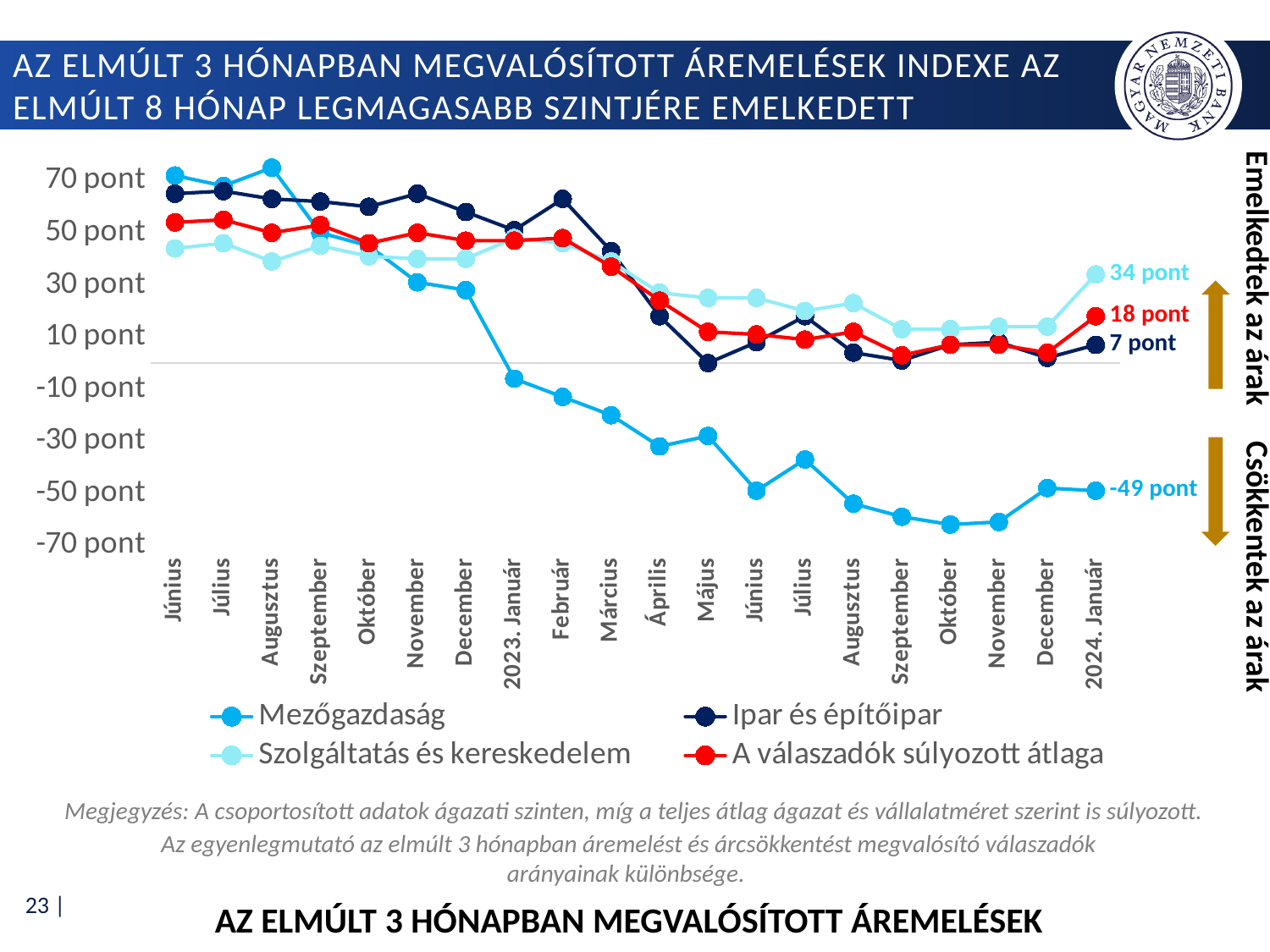
Does the Mezőgazdaság series rise or fall overall from Június 2022 to 2024. Január? fall What is the value for Szolgáltatás és kereskedelem in 2024. Január? 34 pont Which series has the lowest value in 2024. Január? Mezőgazdaság What is the difference between the Szolgáltatás és kereskedelem and A válaszadók súlyozott átlaga values in 2024. Január? 16 pont What is the value for Ipar és építőipar in 2024. Január? 7 pont What is the value for Mezőgazdaság in 2024. Január? -49 pont How many series does the legend list? 4 What kind of chart is shown on the slide? line chart How many time points are plotted along the x axis? 20 What is the value for A válaszadók súlyozott átlaga in 2024. Január? 18 pont Which series has the highest value in 2024. Január? Szolgáltatás és kereskedelem Is the value for Mezőgazdaság in Október 2023 greater or less than -50 pont? less